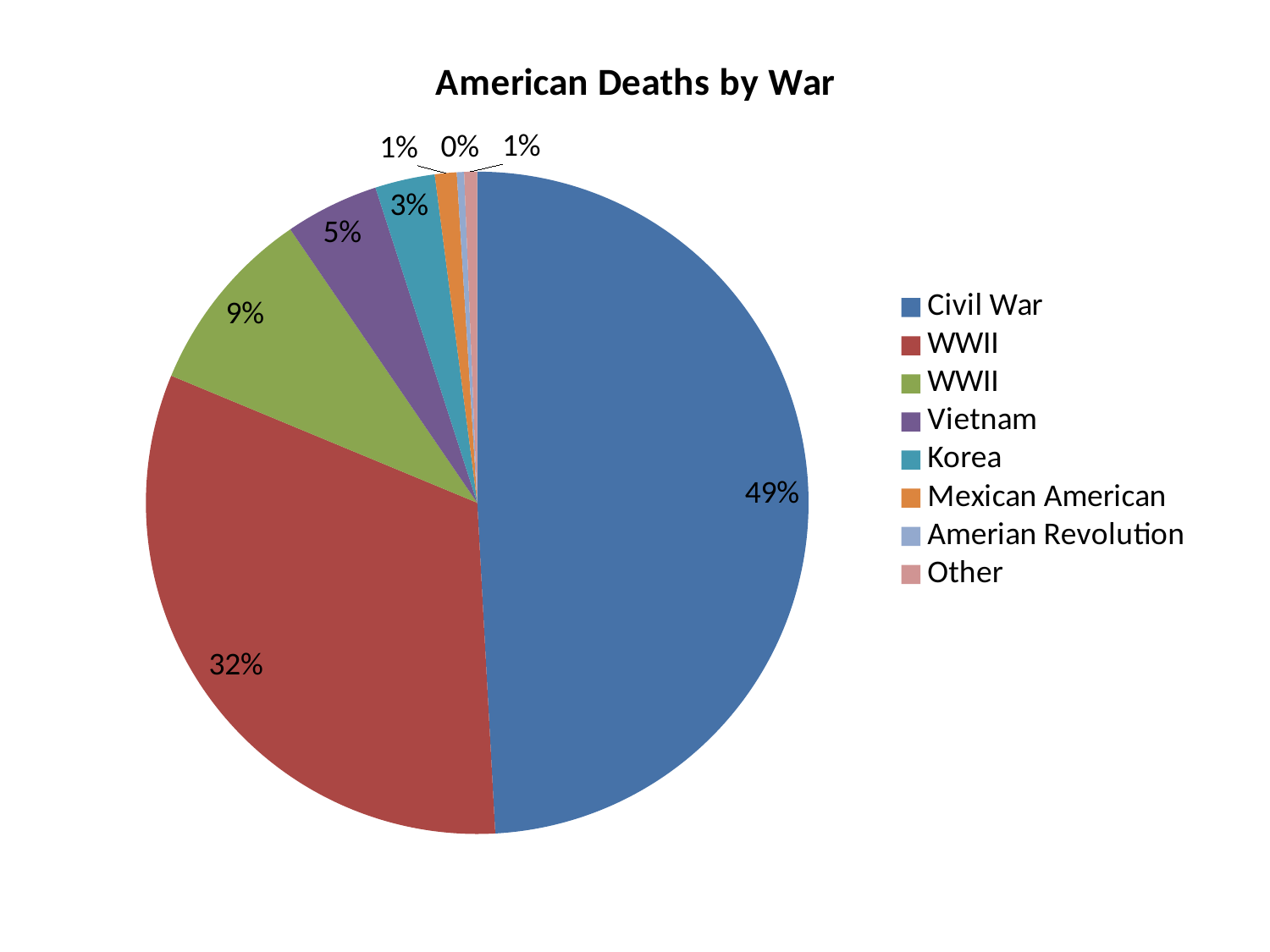
What percentage is shown for Korea? 3% What percentage is shown for Mexican American? 1% Which war has the largest slice of the pie? Civil War What is the title of the chart? American Deaths by War What type of chart is shown on the slide? pie chart What share of American deaths does the Civil War account for? 49% Which has a larger share, Vietnam or Korea? Vietnam How many categories does the legend list? 8 What percentage is shown for Amerian Revolution? 0% What is the difference in percentage points between the Civil War and Vietnam slices? 44 What percentage is shown for Vietnam? 5% Which category has the smallest share of the pie? Amerian Revolution